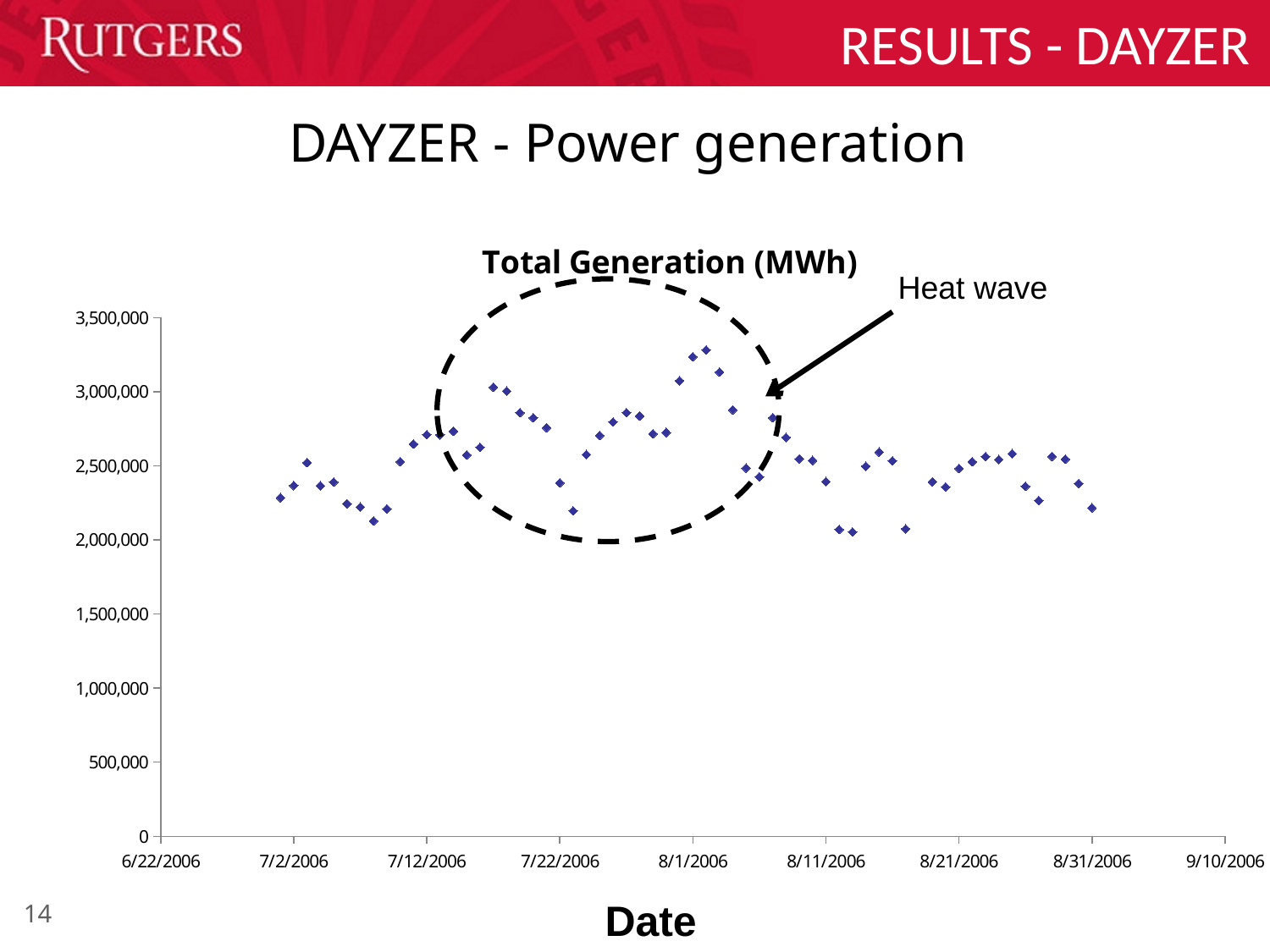
Is the highest plotted value on the chart greater or less than 3,000,000? greater What is the highest value shown on the y axis of the chart? 3,500,000 What is the title of the chart? Total Generation (MWh) What is the label of the x axis of the chart? Date Are any plotted values on the chart greater than 3,500,000? No Is the lowest plotted value on the chart greater or less than 2,500,000? less What kind of chart is shown on the slide? scatter chart Around which date on the x axis do the plotted values reach their peak? 8/1/2006 Do the plotted values rise or fall between 7/22/2006 and 8/1/2006? rise